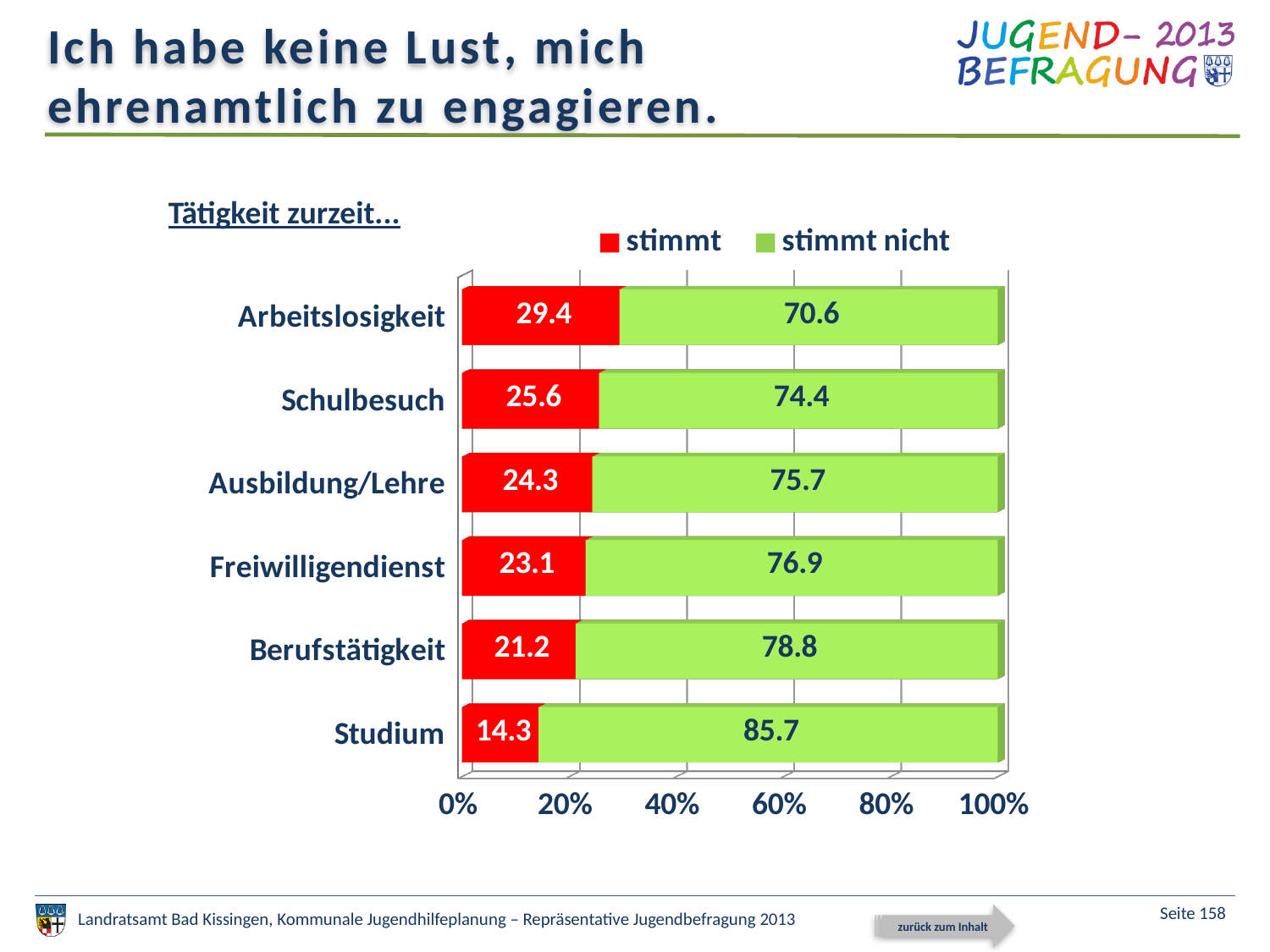
What kind of chart is shown on the slide? stacked bar chart Which category has the lowest 'stimmt' value? Studium What is the 'stimmt' value for Freiwilligendienst? 23.1 What is the difference between the 'stimmt' values for Schulbesuch and Berufstätigkeit? 4.4 Is the 'stimmt' value for Studium greater or less than 20%? less How many categories are shown on the chart? 6 Which category has the highest 'stimmt' value? Arbeitslosigkeit Which is larger, the 'stimmt nicht' value for Ausbildung/Lehre or for Berufstätigkeit? Berufstätigkeit What is the 'stimmt nicht' value for Studium? 85.7 What colour represents 'stimmt nicht' in the chart? green What is the 'stimmt' value for Arbeitslosigkeit? 29.4 How many series does the legend list? 2